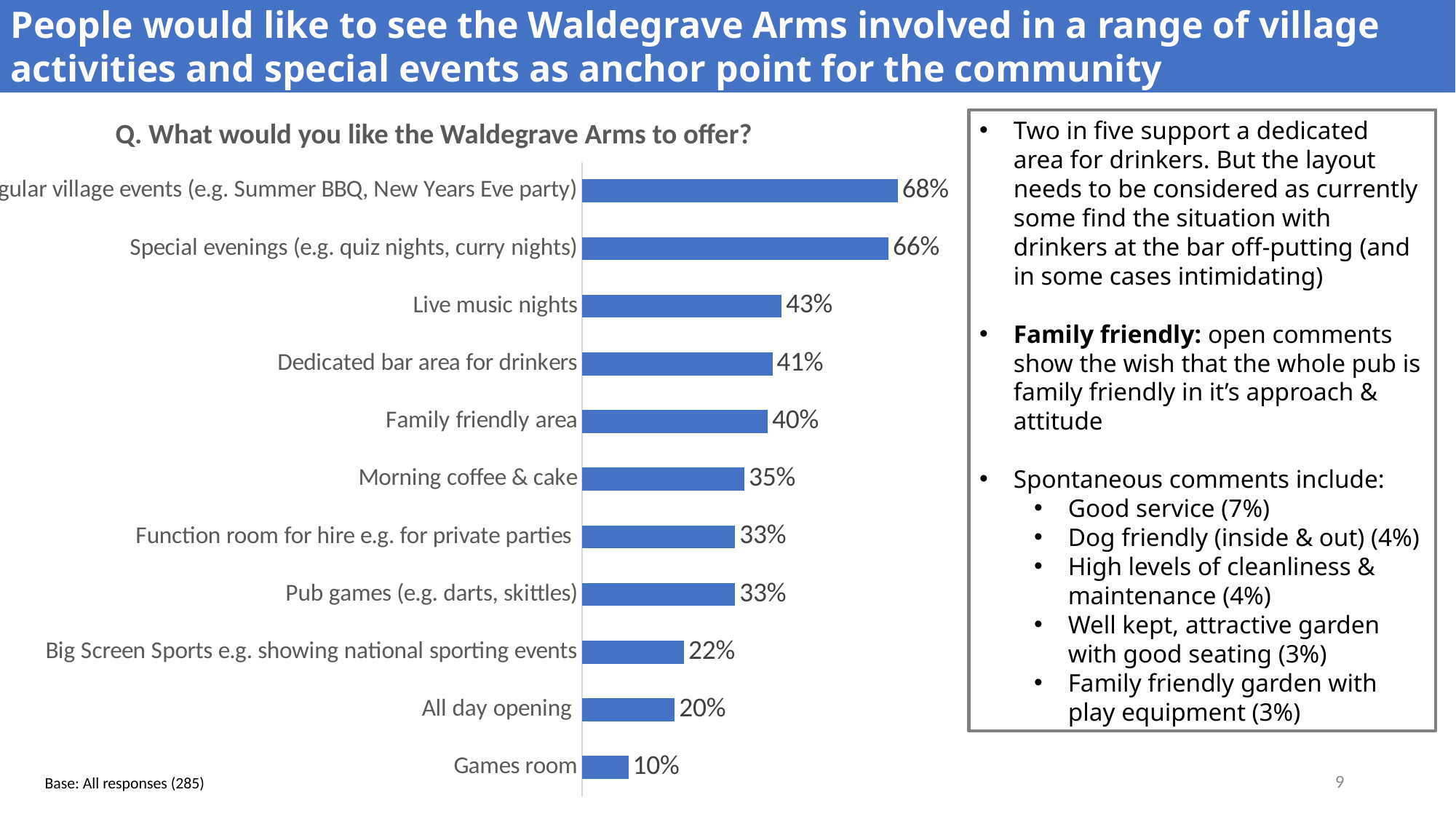
Which category has the highest value in the chart? Regular village events (e.g. Summer BBQ, New Years Eve party) What is the value for 'Morning coffee & cake'? 35% What is the difference between the values for 'All day opening' and 'Games room'? 10% What percentage of respondents would like the Waldegrave Arms to offer live music nights? 43% What question is the chart titled with? Q. What would you like the Waldegrave Arms to offer? What is the difference between the values for 'Special evenings (e.g. quiz nights, curry nights)' and 'Live music nights'? 23% Which has a larger value: 'Family friendly area' or 'Big Screen Sports e.g. showing national sporting events'? Family friendly area Which category has the lowest value in the chart? Games room What type of chart is shown on the slide? Bar chart What is the value shown for 'Dedicated bar area for drinkers'? 41% How many categories are shown in the bar chart? 11 What percentage is shown for 'Games room'? 10%